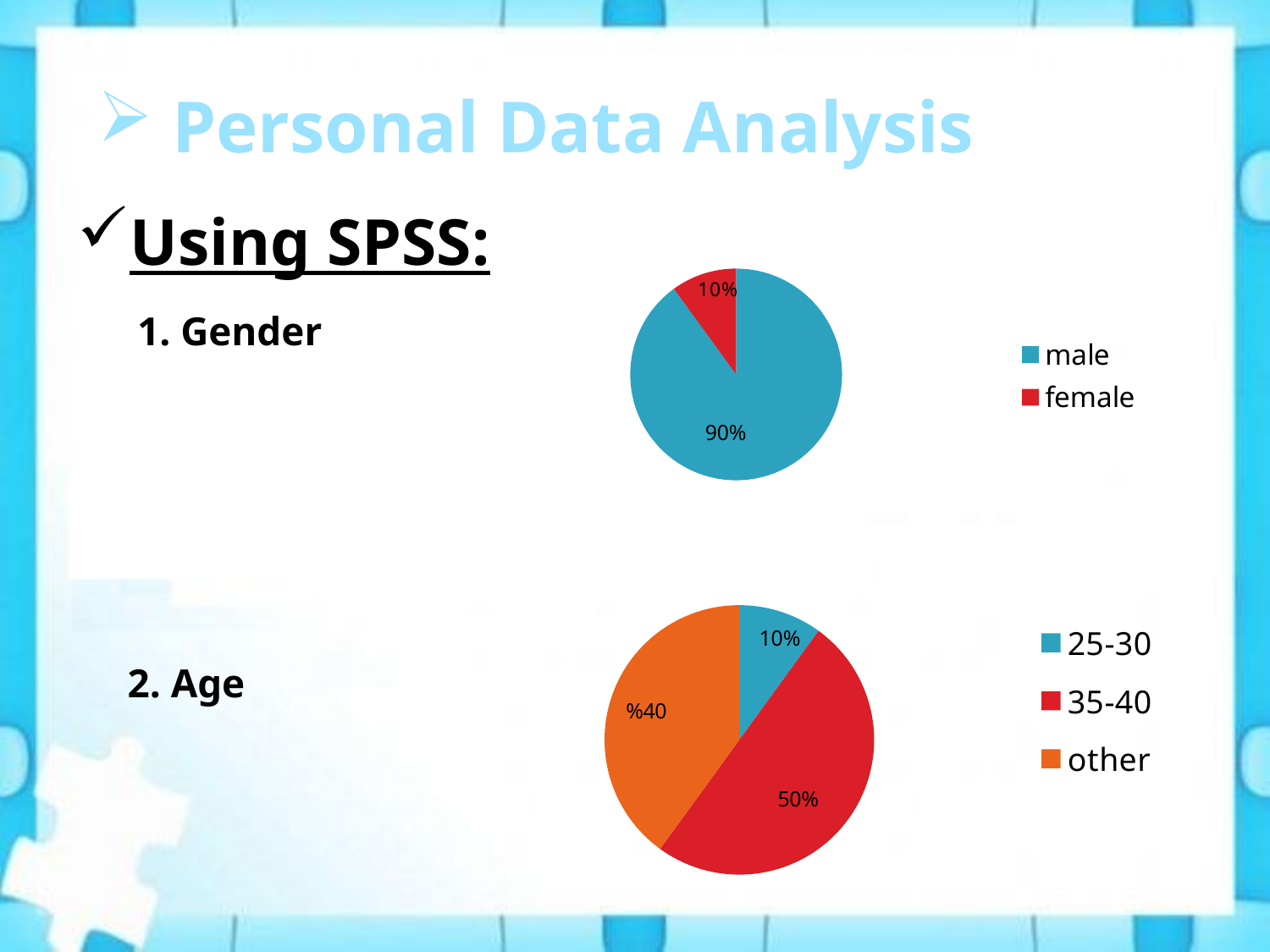
How many categories does the Gender pie chart's legend list? 2 In the Age pie chart, which category has the smallest slice? 25-30 In the Gender pie chart, what is the difference between the male and female shares? 80% How many categories does the Age pie chart's legend list? 3 In the Age pie chart, what share is labelled for 25-30? 10% In the Gender pie chart, what share is labelled for female? 10% In the Gender pie chart, what share is labelled for male? 90% In the Gender pie chart, which category has the largest slice? male In the Age pie chart, which slice is larger, 35-40 or other? 35-40 What type of chart is used for the Age data? pie chart In the Age pie chart, which category has the largest slice? 35-40 In the Age pie chart, what share is labelled for 35-40? 50%